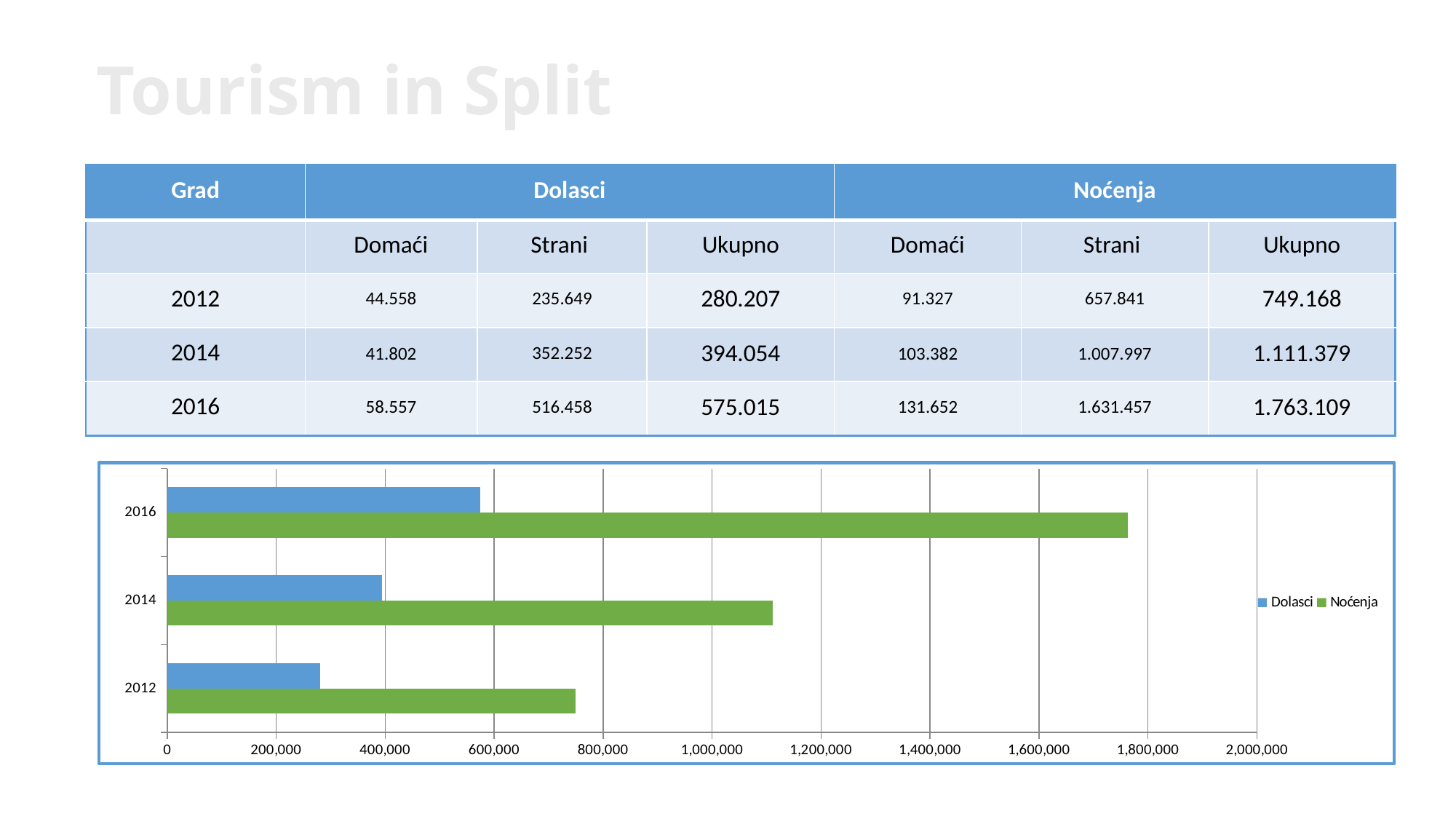
Do the Dolasci values in the chart rise or fall from 2012 to 2016? rise In the chart, is the Noćenja value for 2012 greater or less than 800,000? less Which year has the lowest Dolasci value in the chart? 2012 In the chart, which is larger for 2014: Dolasci or Noćenja? Noćenja In the chart, is the Noćenja value for 2014 greater or less than 1,000,000? greater Which year has the highest Noćenja value in the chart? 2016 What are the two series named in the chart legend? Dolasci and Noćenja How many years are shown on the chart's vertical axis? 3 What kind of chart is shown on the slide? bar chart In the chart, is the Noćenja value for 2016 greater or less than 1,600,000? greater How many series does the chart legend list? 2